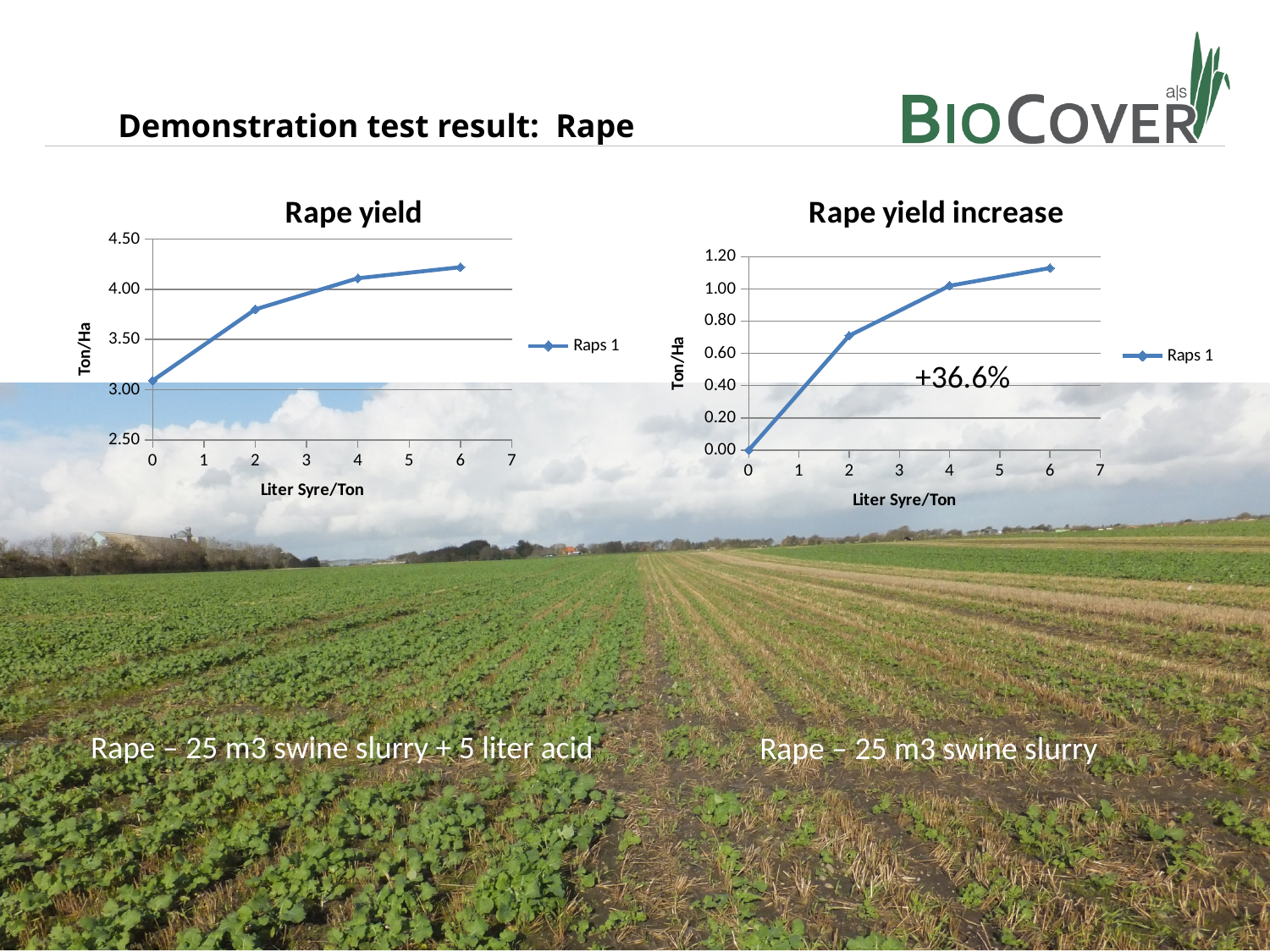
In the "Rape yield" chart, is the value at 6 Liter Syre/Ton greater or less than 4.00? greater In the "Rape yield increase" chart, at which Liter Syre/Ton value is the yield increase highest? 6 What percentage annotation is printed on the "Rape yield increase" chart? +36.6% In the "Rape yield" chart, which is larger, the value at 2 Liter Syre/Ton or the value at 4 Liter Syre/Ton? 4 Liter Syre/Ton What is the name of the series shown in the legend of the "Rape yield increase" chart? Raps 1 In the "Rape yield" chart, how many data points are plotted? 4 In the "Rape yield" chart, do the values rise or fall as Liter Syre/Ton increases? rise What kind of chart is the "Rape yield" chart? line chart In the "Rape yield increase" chart, what is the value at 0 Liter Syre/Ton? 0.00 In the "Rape yield increase" chart, is the value at 4 Liter Syre/Ton greater or less than 0.80? greater In the "Rape yield" chart, how many series does the legend list? 1 In the "Rape yield" chart, is the value at 0 Liter Syre/Ton greater or less than 3.50? less